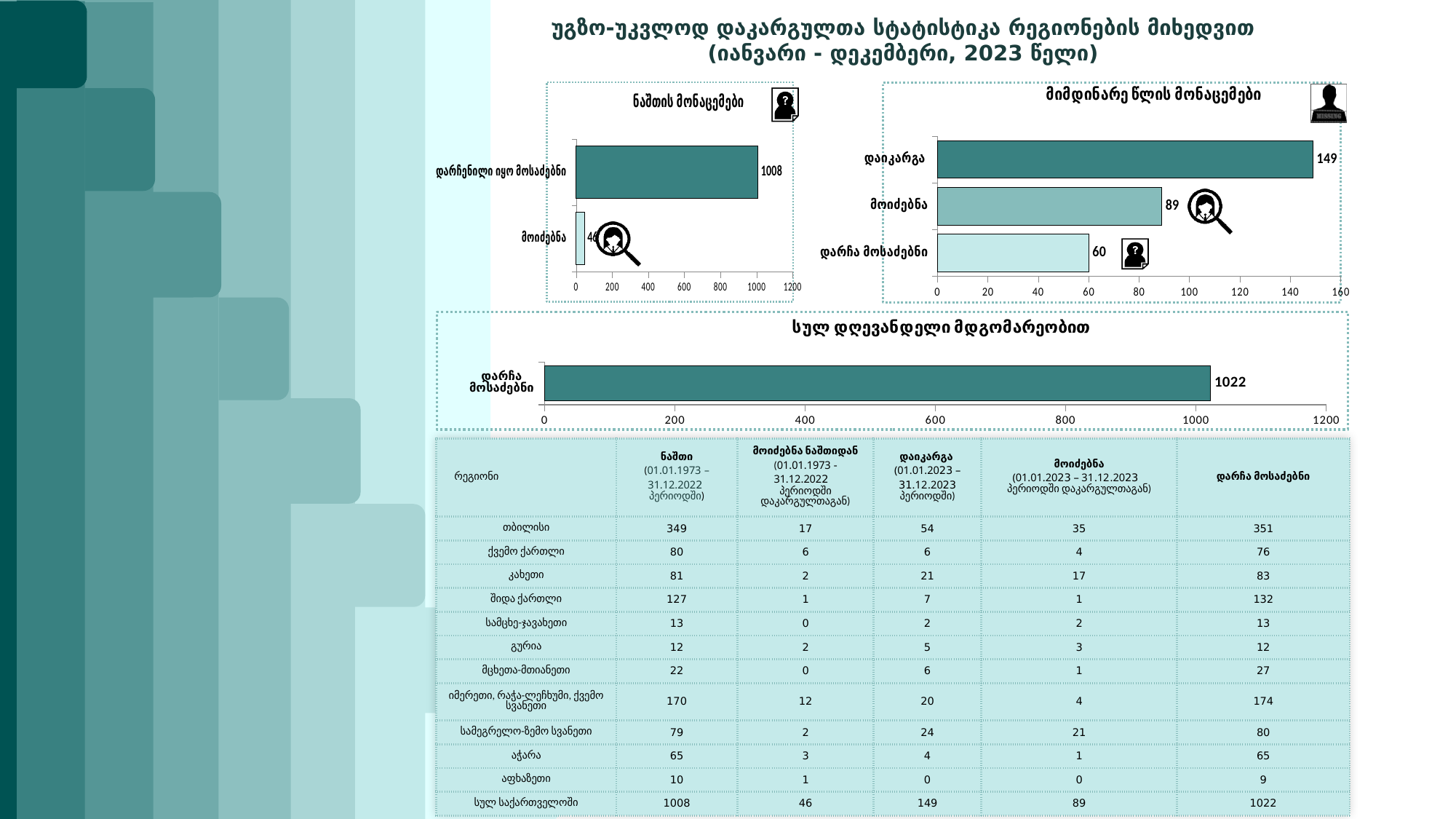
In the chart titled "სულ დღევანდელი მდგომარეობით" (bottom), what is the value for "დარჩა მოსაძებნი"? 1022 What type of chart is the one titled "სულ დღევანდელი მდგომარეობით" (bottom)? bar chart In the chart titled "ნაშთის მონაცემები" (top left), which category has the highest value? დარჩენილი იყო მოსაძებნი In the chart titled "მიმდინარე წლის მონაცემები" (top right), what is the value for "დაიკარგა"? 149 In the chart titled "მიმდინარე წლის მონაცემები" (top right), what is the value for "დარჩა მოსაძებნი"? 60 In the chart titled "მიმდინარე წლის მონაცემები" (top right), what is the value for "მოიძებნა"? 89 In the chart titled "ნაშთის მონაცემები" (top left), is the value for "მოიძებნა" greater or less than 200? less In the chart titled "მიმდინარე წლის მონაცემები" (top right), which category has the lowest value? დარჩა მოსაძებნი In the chart titled "მიმდინარე წლის მონაცემები" (top right), which is larger, "მოიძებნა" or "დარჩა მოსაძებნი"? მოიძებნა In the chart titled "მიმდინარე წლის მონაცემები" (top right), what is the difference between "დაიკარგა" and "მოიძებნა"? 60 In the chart titled "ნაშთის მონაცემები" (top left), what is the value for "დარჩენილი იყო მოსაძებნი"? 1008 In the chart titled "ნაშთის მონაცემები" (top left), how many categories are plotted? 2